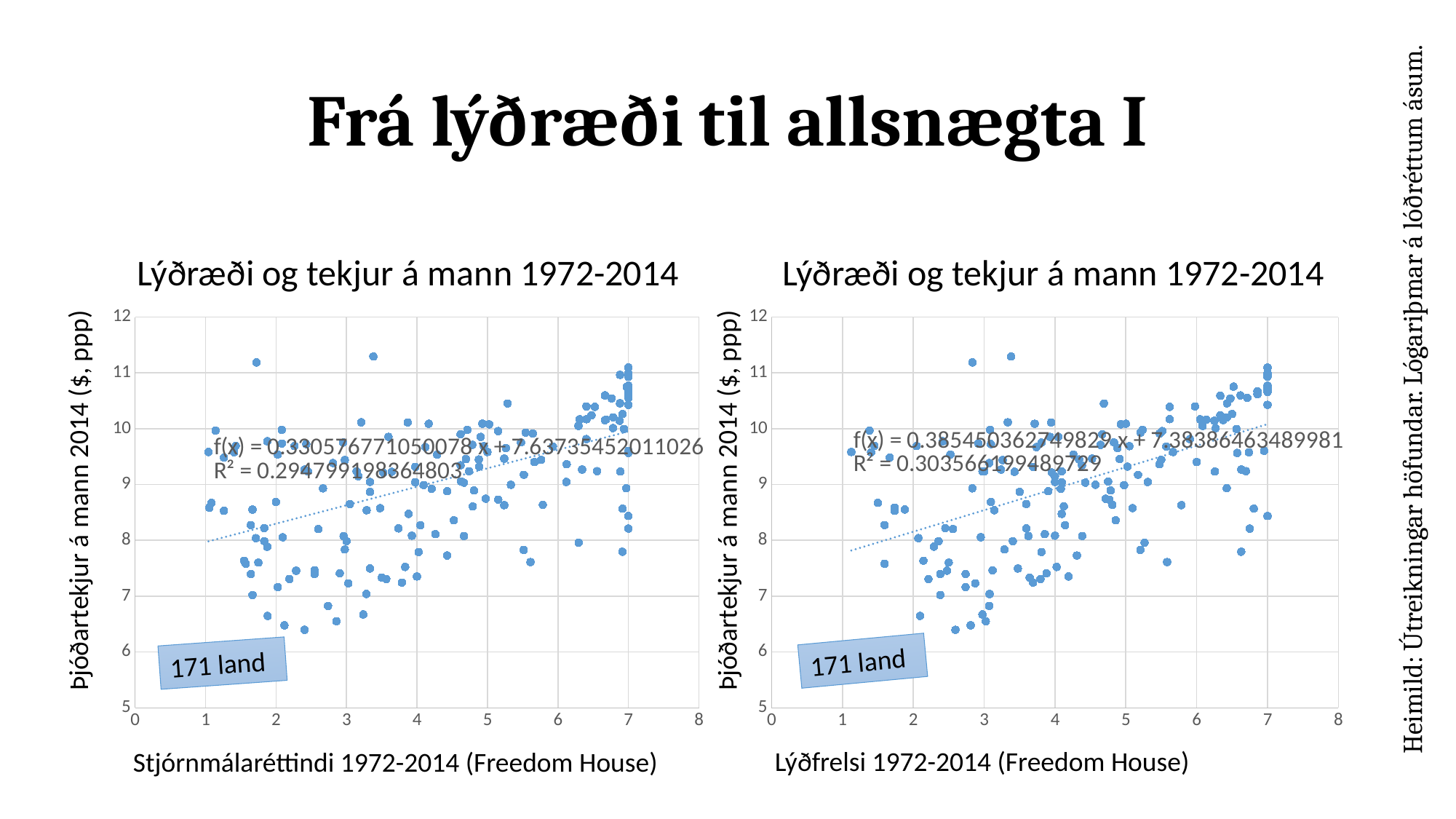
What is the R² value shown on the right chart? 0.303566199489729 What is the R² value shown on the left chart? 0.294799198364803 In the left chart, do the values generally rise or fall as the x-axis value increases? rise According to the label on the right chart, how many countries (points) are plotted? 171 What is the x-axis label of the left chart? Stjórnmálaréttindi 1972-2014 (Freedom House) In the right chart, do the values generally rise or fall as the x-axis value increases? rise According to the label on the left chart, how many countries (points) are plotted? 171 What kind of chart is the right chart on the slide? scatter chart In the right chart, is the lowest plotted point greater or less than 7 on the y-axis? less In the left chart, is the highest plotted point greater or less than 11 on the y-axis? greater What kind of chart is the left chart on the slide? scatter chart